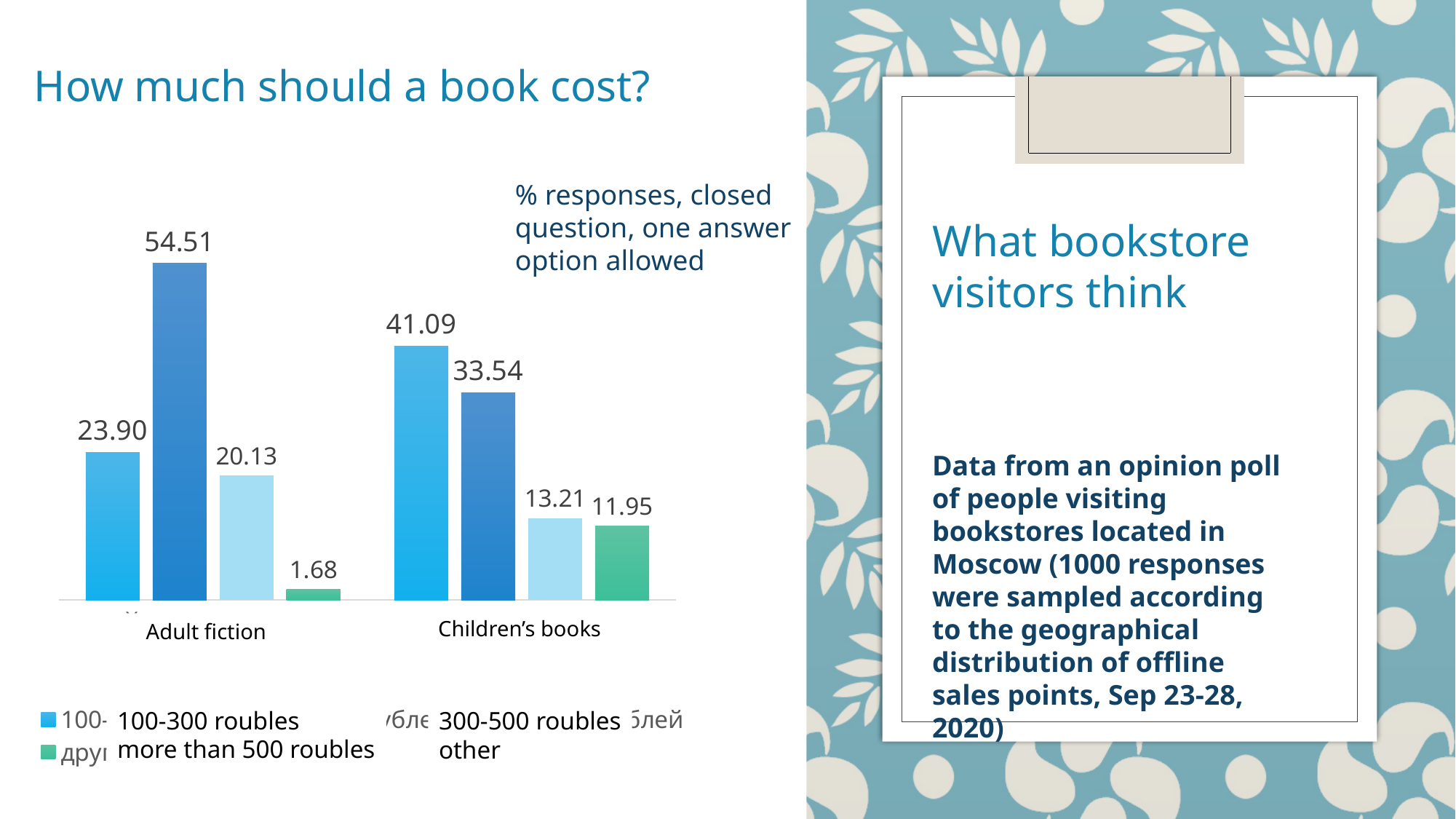
What kind of chart is shown on the slide? bar chart What is the difference between the 300-500 roubles values for Adult fiction and Children's books? 20.97 What is the value for 'other' in the Adult fiction category? 1.68 Which is larger: the 100-300 roubles value for Adult fiction or for Children's books? Children's books How many categories are shown on the x axis of the chart? 2 Which price range has the highest value for Adult fiction? 300-500 roubles What is the title of the slide containing the chart? How much should a book cost? What is the value for 100-300 roubles in the Children's books category? 41.09 What is the value for 'more than 500 roubles' in the Children's books category? 13.21 Which price range has the lowest value for Children's books? other What is the value for 300-500 roubles in the Adult fiction category? 54.51 How many series does the chart's legend list? 4